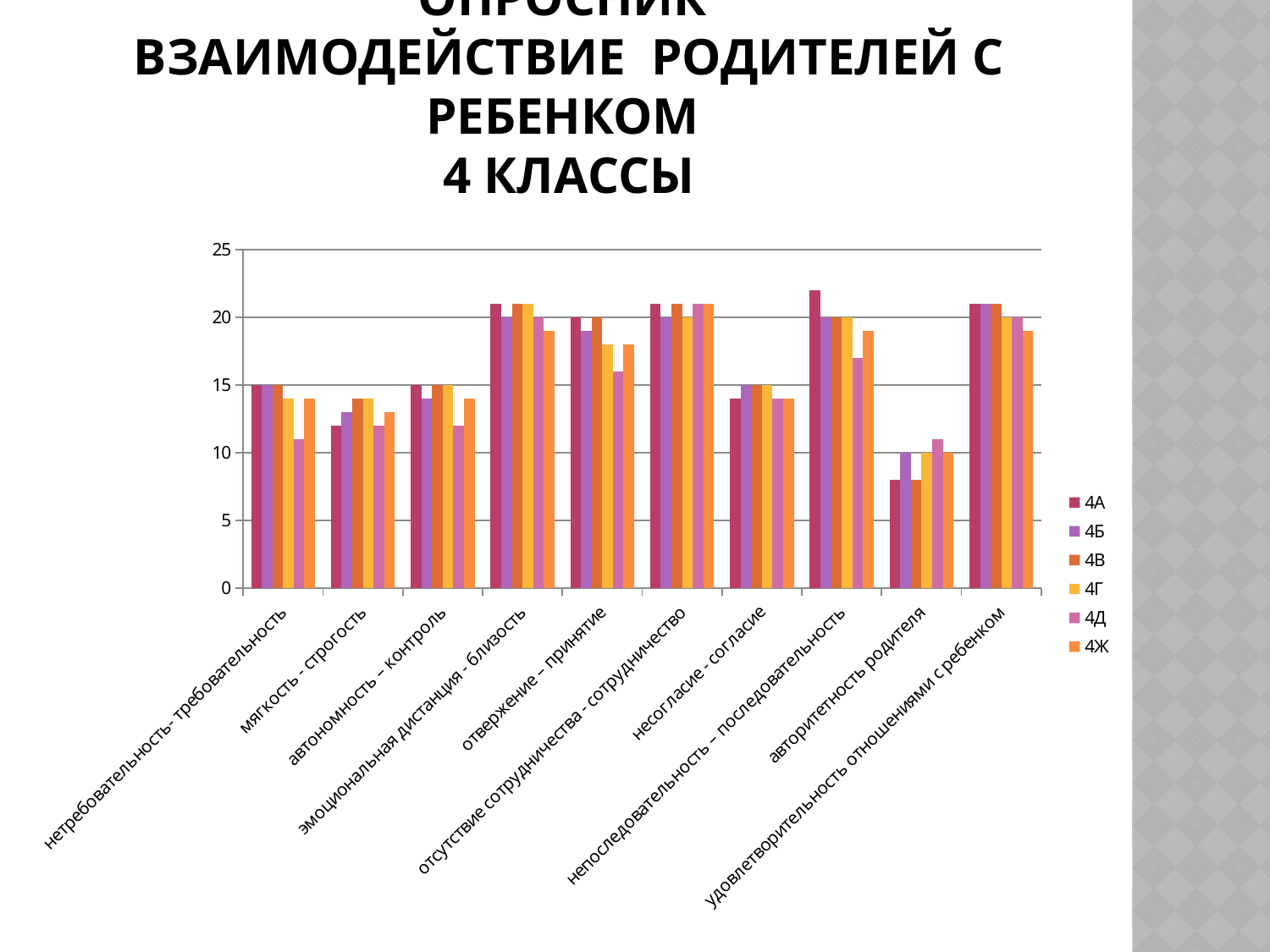
In the category 'нетребовательность- требовательность', which is larger: the value for 4А or for 4Д? 4А Is the value for 4А in the category 'непоследовательность – последовательность' greater or less than 20? greater What is the value for 4В in the category 'непоследовательность – последовательность'? 20 Is the value for 4А in the category 'авторитетность родителя' greater or less than 10? less What is the value for 4Г in the category 'удовлетворительность отношениями с ребенком'? 20 How many categories are shown along the x axis? 10 Which category has the lowest values across all series? авторитетность родителя What kind of chart is shown on the slide? bar chart Which series is listed first in the legend? 4А What is the value for 4А in the category 'нетребовательность- требовательность'? 15 What is the value for 4Б in the category 'авторитетность родителя'? 10 How many series does the legend list? 6